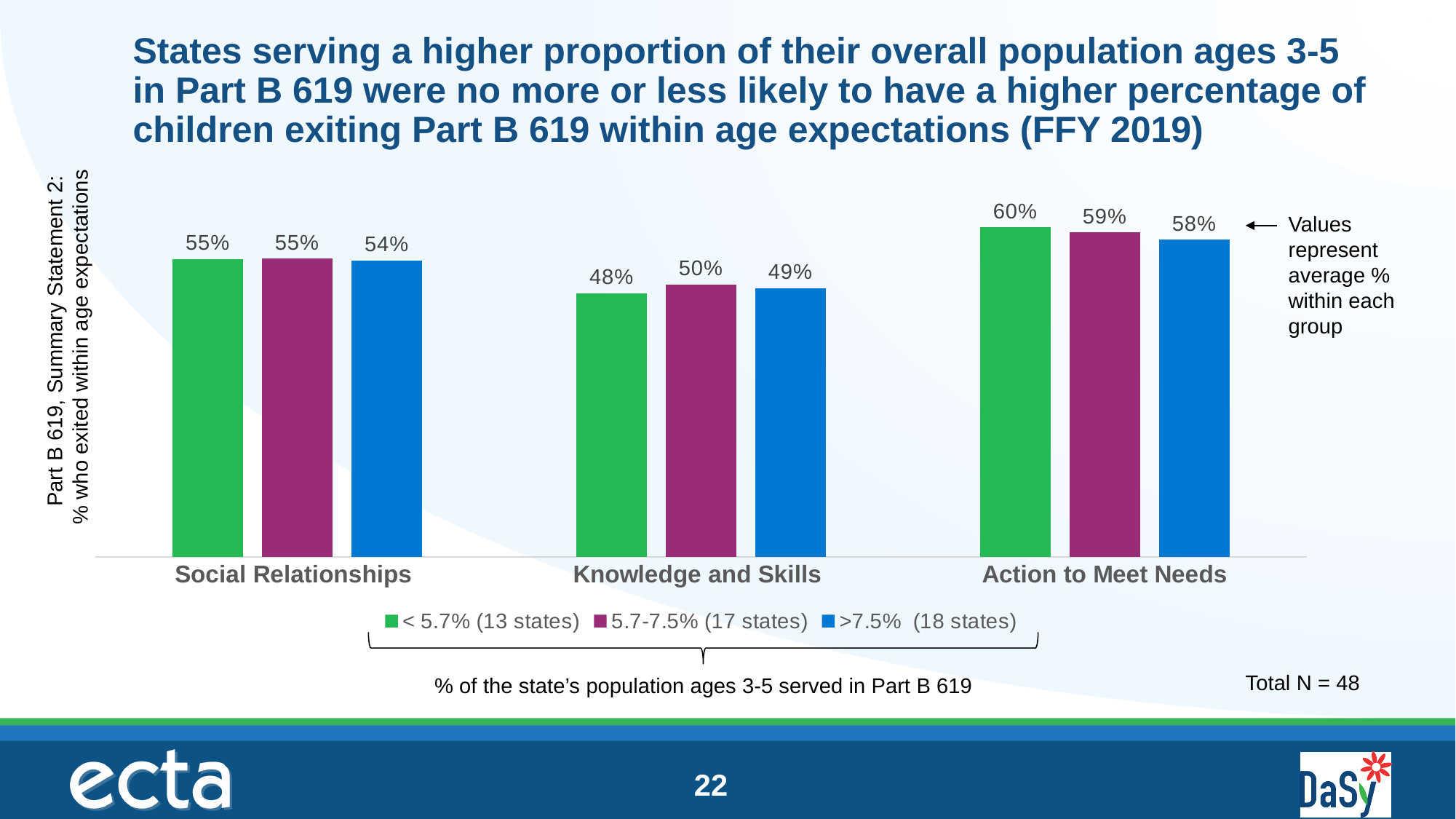
What is the difference between the < 5.7% group's value in Action to Meet Needs and its value in Knowledge and Skills? 12% Which colour represents the >7.5% (18 states) group? Blue What is the value for the 5.7-7.5% (17 states) group in the Action to Meet Needs category? 59% What kind of chart is shown on the slide? Bar chart Which group has the highest value in the Action to Meet Needs category? < 5.7% (13 states) Which group has the lowest value in the Knowledge and Skills category? < 5.7% (13 states) What is the value for the < 5.7% (13 states) group in the Social Relationships category? 55% Which is larger: the 5.7-7.5% group's value in Knowledge and Skills or the >7.5% group's value in Knowledge and Skills? 5.7-7.5% (17 states) How many series does the legend list? 3 What is the total N stated on the slide? 48 How many categories are shown on the x axis? 3 What is the value for the >7.5% (18 states) group in the Knowledge and Skills category? 49%